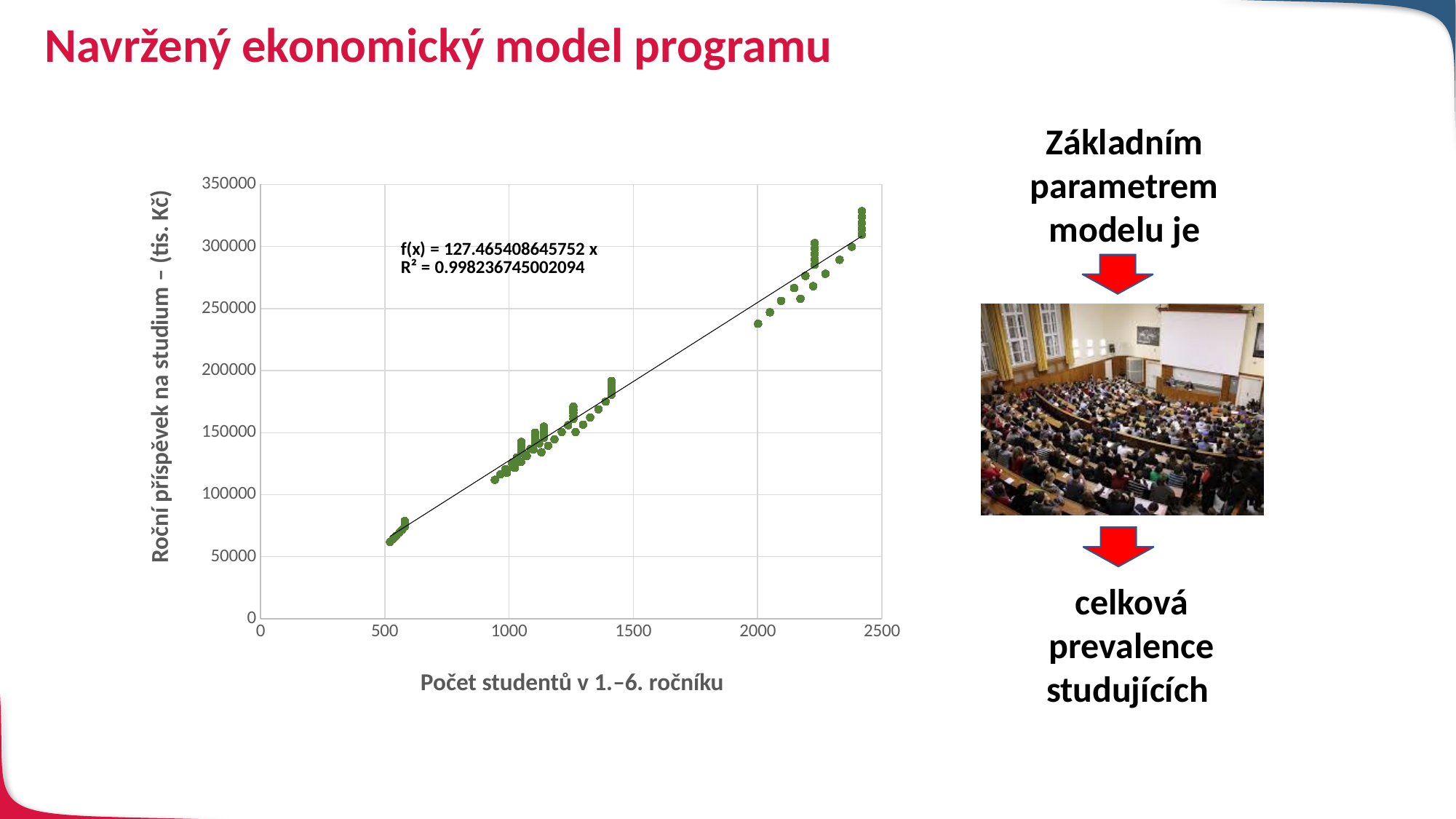
What is the title of the x axis of the chart? Počet studentů v 1.–6. ročníku What is the highest value shown on the y axis of the chart? 350000 Are the values for the points at around 2400 students greater or less than 300000? greater What kind of chart is shown on the slide? scatter chart Are the values for the points at around 500 students greater or less than 100000? less Do the plotted values rise or fall as the number of students increases along the x axis? rise What R² value is printed on the chart? 0.998236745002094 Are the values for the points at around 1000 students greater or less than 100000? greater What is the title of the y axis of the chart? Roční příspěvek na studium – (tis. Kč) What is the trendline equation printed on the chart? f(x) = 127.465408645752 x What is the highest value shown on the x axis of the chart? 2500